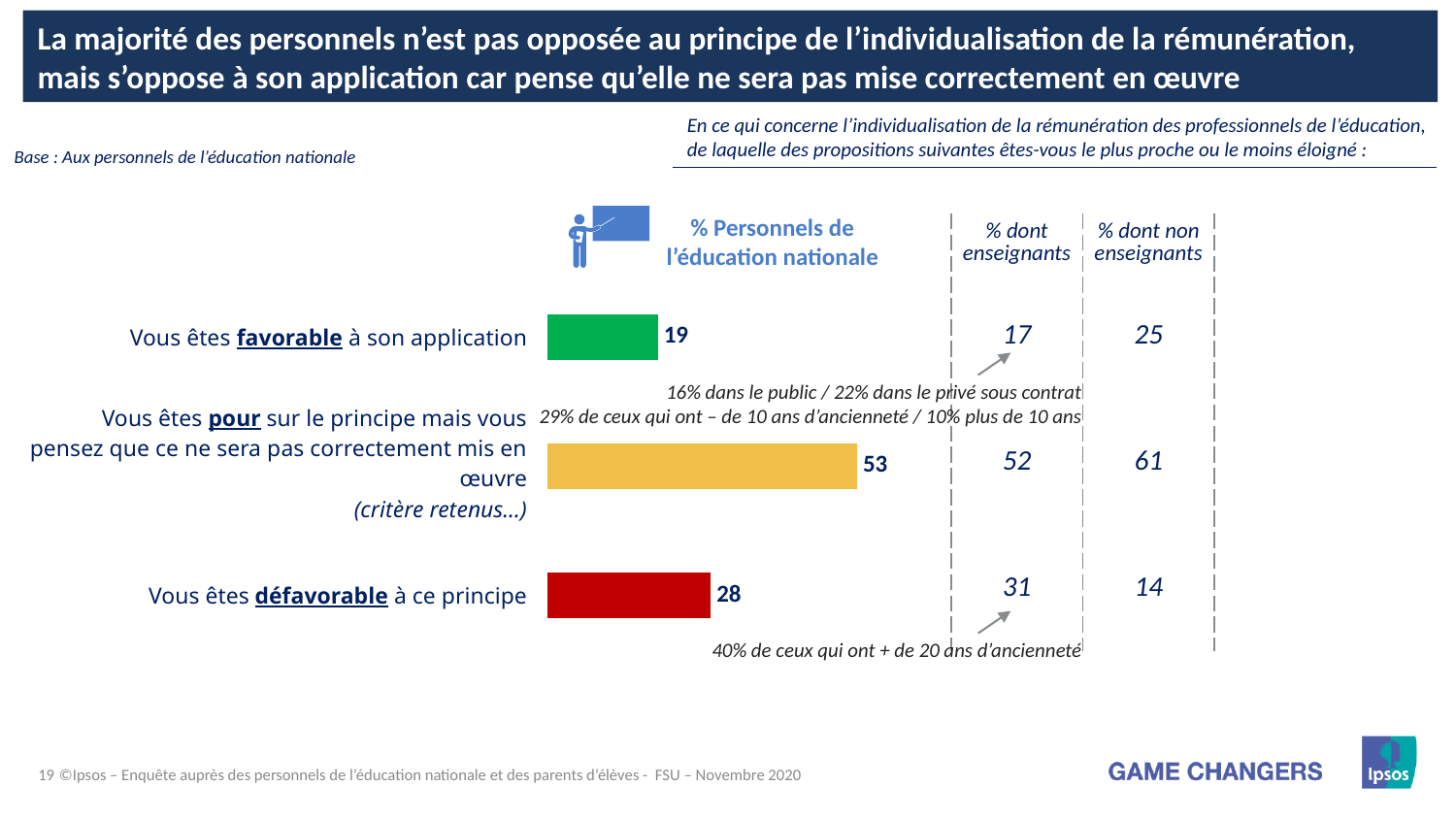
What is the '% dont non enseignants' value for 'pour sur le principe mais vous pensez que ce ne sera pas correctement mis en œuvre'? 61 How many response categories are shown in the bar chart? 3 What colour is the bar for 'défavorable à ce principe'? Red Which response has the lowest percentage among personnels de l'éducation nationale? Vous êtes favorable à son application What is the '% dont enseignants' value for 'défavorable à ce principe'? 31 What percentage of personnels de l'éducation nationale are 'pour sur le principe mais pensez que ce ne sera pas correctement mis en œuvre'? 53 Which response has the highest percentage among personnels de l'éducation nationale? Vous êtes pour sur le principe mais vous pensez que ce ne sera pas correctement mis en œuvre What is the difference in percentage points between 'défavorable à ce principe' and 'favorable à son application' among personnels de l'éducation nationale? 9 What kind of chart is used to show the % Personnels de l'éducation nationale? Bar chart Which is larger among personnels de l'éducation nationale: the share 'défavorable à ce principe' or the share 'favorable à son application'? Vous êtes défavorable à ce principe What percentage of personnels de l'éducation nationale are 'défavorable à ce principe'? 28 What percentage of personnels de l'éducation nationale are 'favorable à son application'? 19